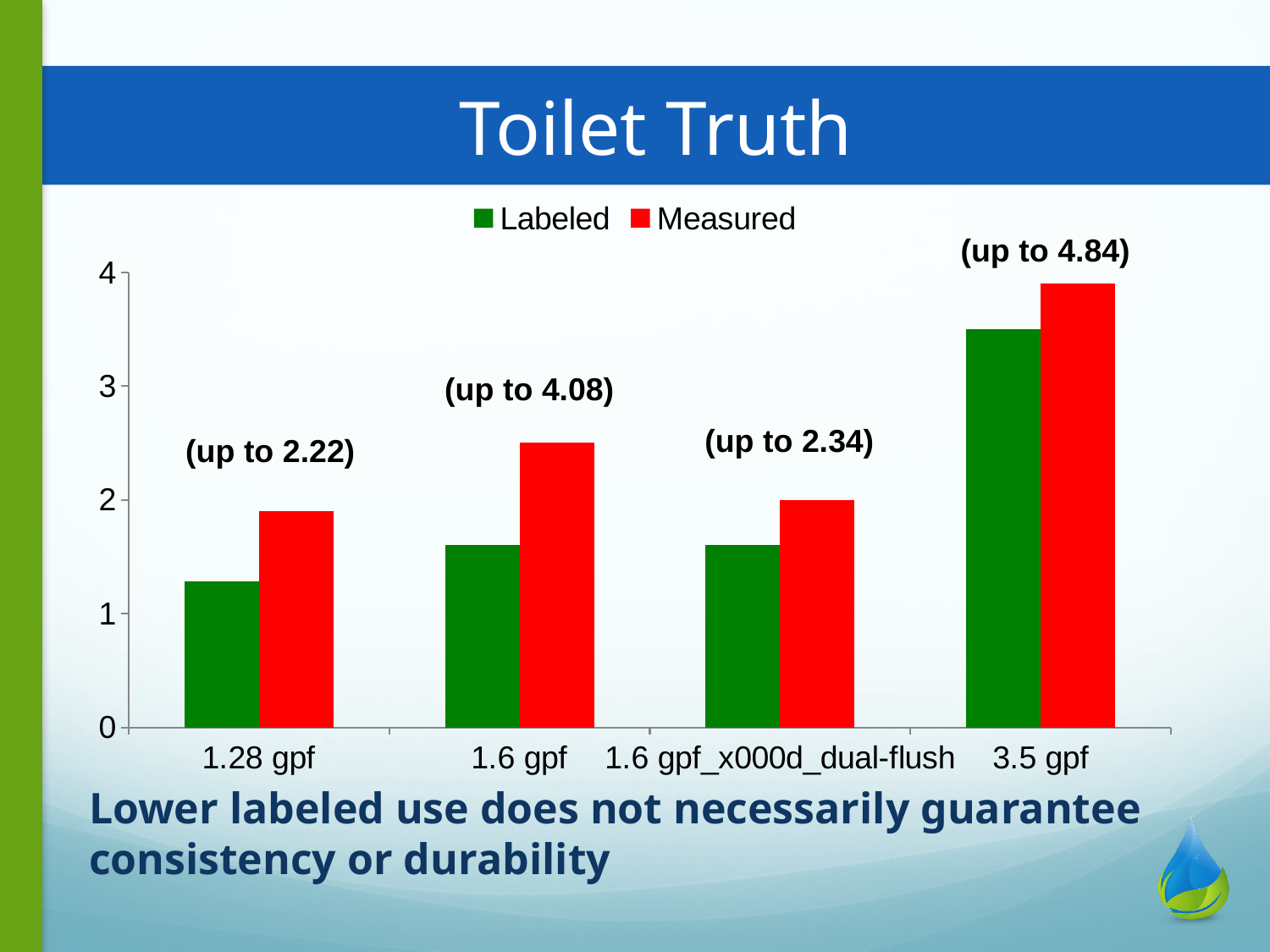
For the 1.6 gpf category, which is larger, the Labeled value or the Measured value? Measured How many series does the legend list? 2 What annotation is printed above the bars for the 3.5 gpf category? (up to 4.84) How many categories are shown on the x axis? 4 What kind of chart is shown on the slide? bar chart What is the title of the chart? Toilet Truth Is the Labeled value for 1.6 gpf greater or less than 2? less Is the Labeled value for 1.28 gpf greater or less than 1? greater Is the Measured value for 3.5 gpf greater or less than 3? greater Which category has the highest Measured value? 3.5 gpf Which category has the lowest Labeled value? 1.28 gpf